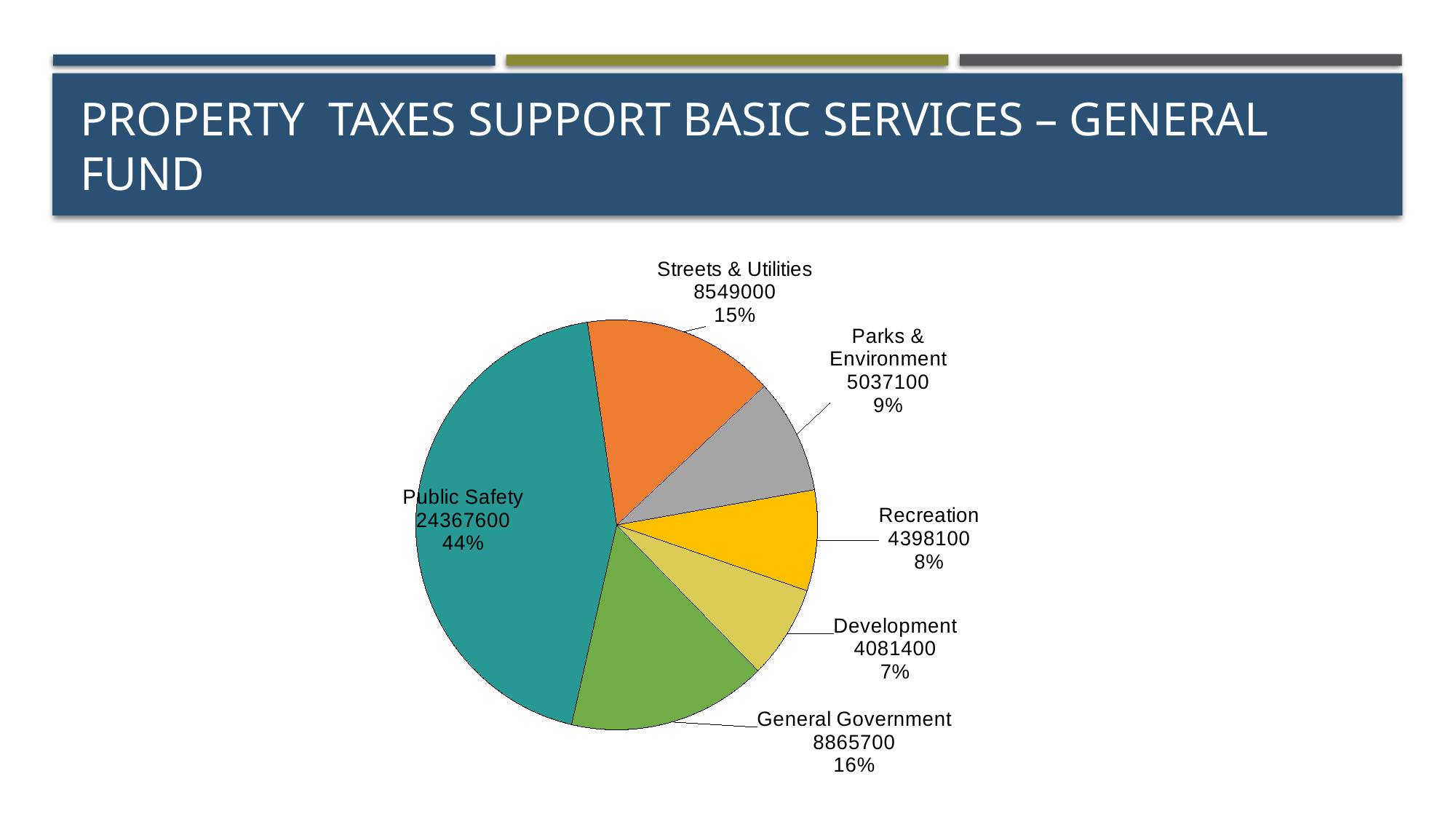
What share of the pie does Parks & Environment represent? 9% What is the value for Streets & Utilities? 8549000 How many categories are shown in the pie chart? 6 What kind of chart is shown on the slide? pie chart What is the value for Recreation? 4398100 Which is larger, Parks & Environment or Recreation? Parks & Environment What is the title of the slide containing the chart? PROPERTY TAXES SUPPORT BASIC SERVICES – GENERAL FUND What is the value for Public Safety? 24367600 Which category has the largest slice? Public Safety Which category has the smallest slice? Development What share of the pie does General Government represent? 16% What is the difference between the values for General Government and Streets & Utilities? 316700